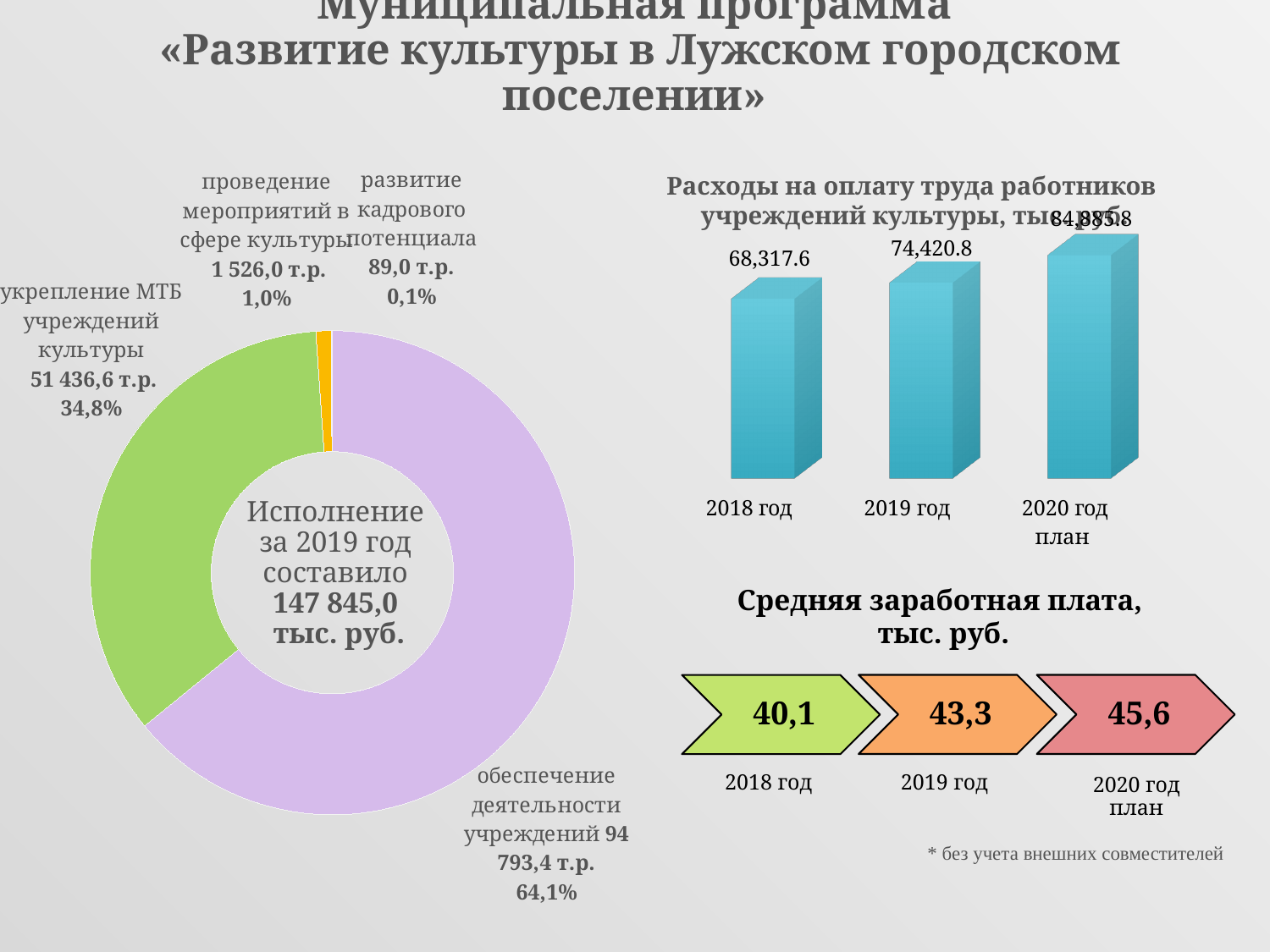
According to the text in the centre of the donut chart, what was the total execution for 2019? 147 845,0 тыс. руб. In the 'Расходы на оплату труда' bar chart, do the values rise or fall from 2018 to 2020? Rise How many categories are shown in the donut chart on the left? 4 In the 'Расходы на оплату труда' bar chart, which year has the highest value? 2020 год план In the 'Расходы на оплату труда' bar chart, what is the value for 2019 год? 74,420.8 What type of chart is the 'Расходы на оплату труда работников учреждений культуры' chart? Bar chart In the 'Расходы на оплату труда' bar chart, what is the value for 2018 год? 68,317.6 In the donut chart on the left, which category has the smallest share? развитие кадрового потенциала What type of chart is shown on the left side of the slide? Donut (pie) chart In the donut chart on the left, what share does 'обеспечение деятельности учреждений' have? 64,1% In the donut chart on the left, which category has the largest share? обеспечение деятельности учреждений In the donut chart on the left, what is the value for 'укрепление МТБ учреждений культуры'? 51 436,6 т.р.